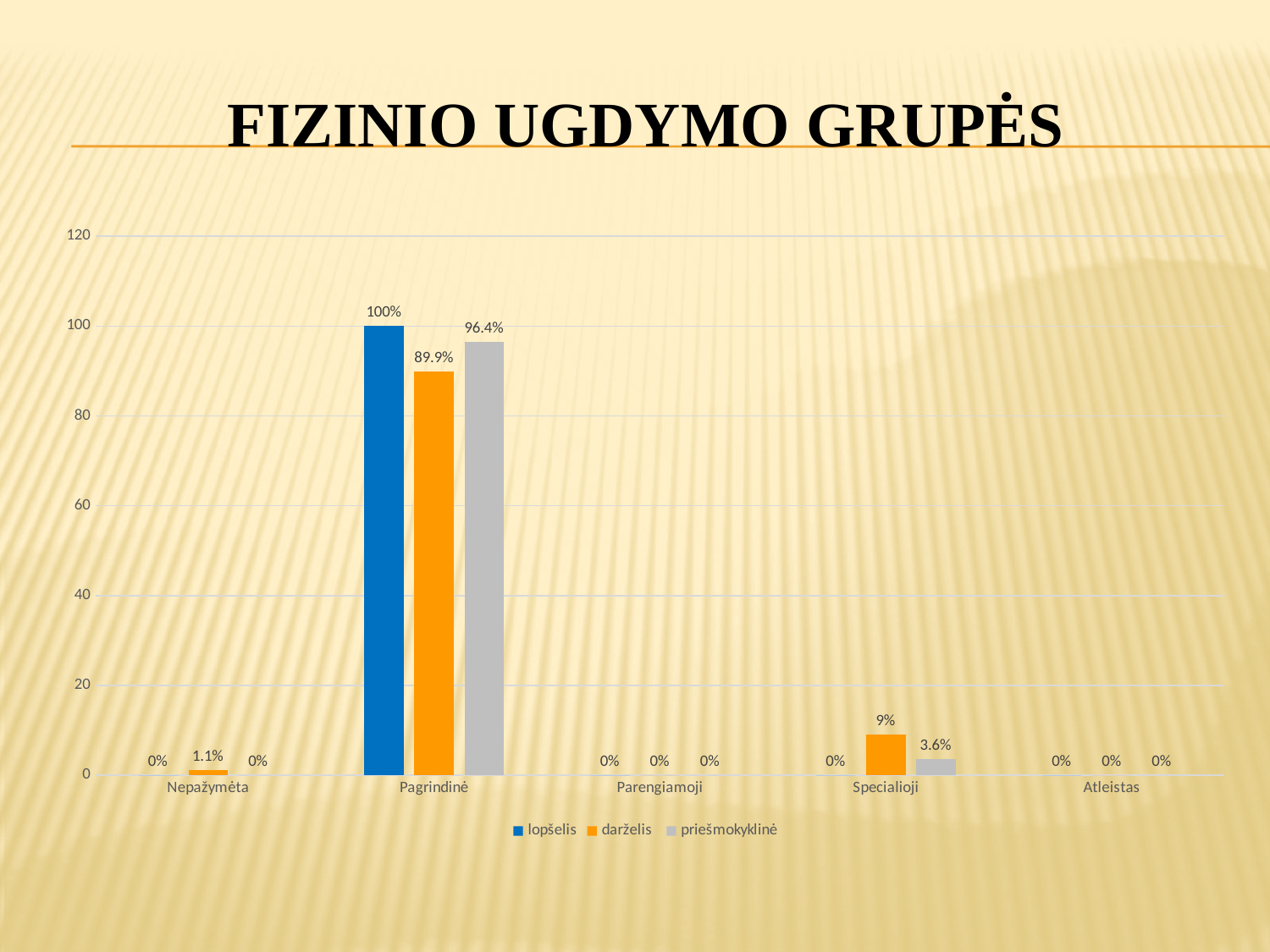
Is the value for priešmokyklinė in the Pagrindinė category greater or less than 80? greater How many categories are shown on the x axis? 5 How many series does the legend list? 3 What is the value for darželis in the Pagrindinė category? 89.9% Which is larger in the Specialioji category: darželis or priešmokyklinė? darželis What is the value for priešmokyklinė in the Specialioji category? 3.6% What kind of chart is shown on the slide? bar chart What is the value for lopšelis in the Pagrindinė category? 100% What is the title of the chart? FIZINIO UGDYMO GRUPĖS Which category has the highest value for priešmokyklinė? Pagrindinė What is the value for darželis in the Nepažymėta category? 1.1% What is the difference between the lopšelis and darželis values in the Pagrindinė category? 10.1%